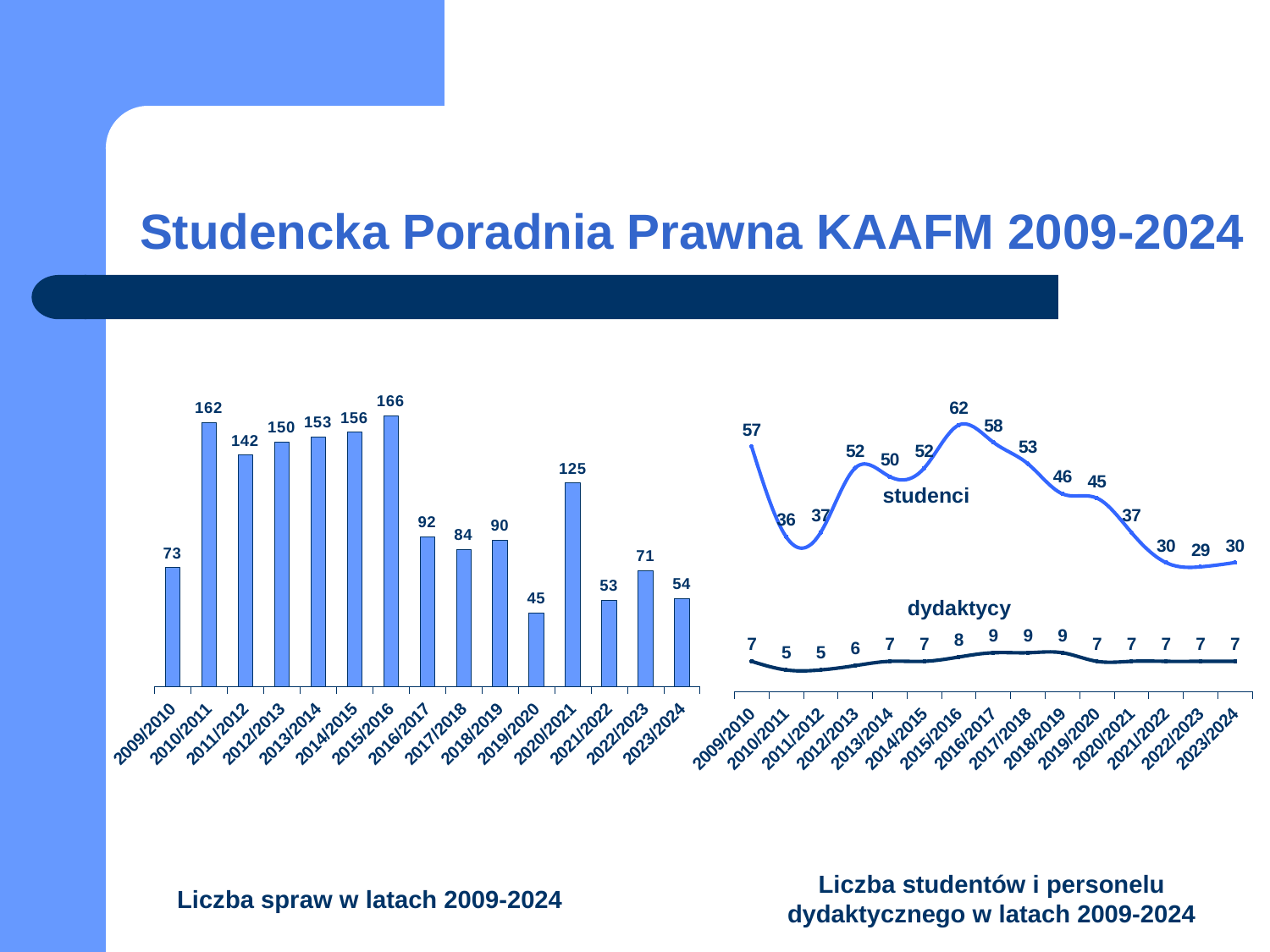
In the right chart (Liczba studentów i personelu dydaktycznego), what is the dydaktycy value for 2012/2013? 6 In the left chart (Liczba spraw w latach 2009-2024), what is the difference between the values for 2010/2011 and 2009/2010? 89 In the left chart (Liczba spraw w latach 2009-2024), which is larger, the value for 2020/2021 or the value for 2016/2017? 2020/2021 In the left chart (Liczba spraw w latach 2009-2024), which year has the highest value? 2015/2016 In the right chart (Liczba studentów i personelu dydaktycznego), which year has the lowest studenci value? 2022/2023 How many series are plotted in the right chart (Liczba studentów i personelu dydaktycznego)? 2 In the left chart (Liczba spraw w latach 2009-2024), what is the value for 2015/2016? 166 In the right chart (Liczba studentów i personelu dydaktycznego), what is the studenci value for 2015/2016? 62 In the left chart (Liczba spraw w latach 2009-2024), which year has the lowest value? 2019/2020 What kind of chart is the left chart (Liczba spraw w latach 2009-2024)? bar chart How many years are shown on the x axis of the left chart (Liczba spraw w latach 2009-2024)? 15 In the right chart (Liczba studentów i personelu dydaktycznego), what is the difference between the studenci and dydaktycy values for 2009/2010? 50